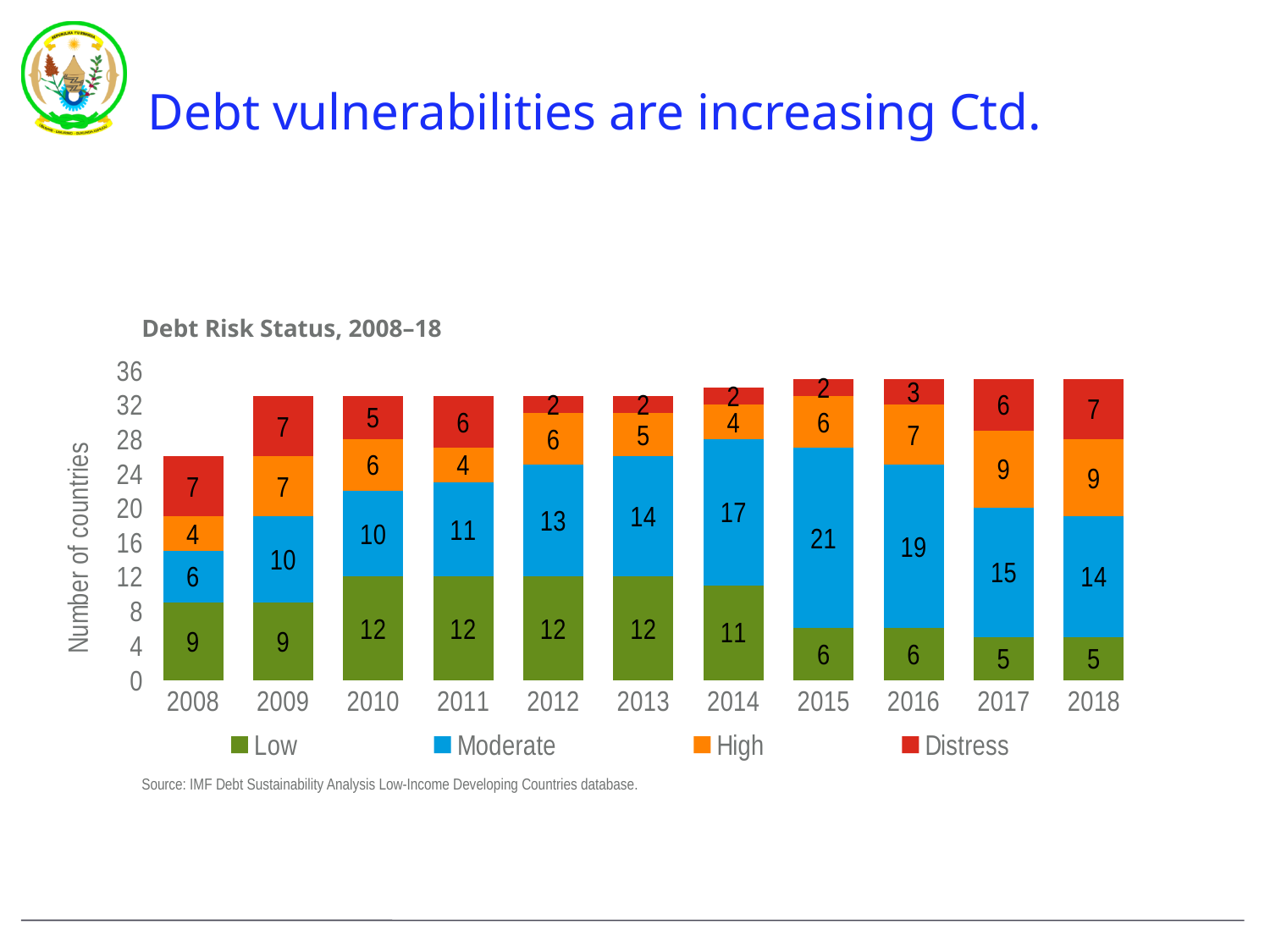
In which year is the Moderate value highest? 2015 Which is larger, the Low value in 2010 or the Low value in 2016? 2010 What is the High value for 2017? 9 What is the Distress value for 2008? 7 What type of chart is shown on the slide? Stacked bar chart What is the total number of countries for 2018? 35 In which year is the Low value lowest? 2017 and 2018 What is the Moderate value for 2015? 21 How many years are shown on the x axis? 11 How many series does the legend list? 4 What is the difference between the Moderate value in 2015 and the Moderate value in 2008? 15 What is the total number of countries for 2008? 26